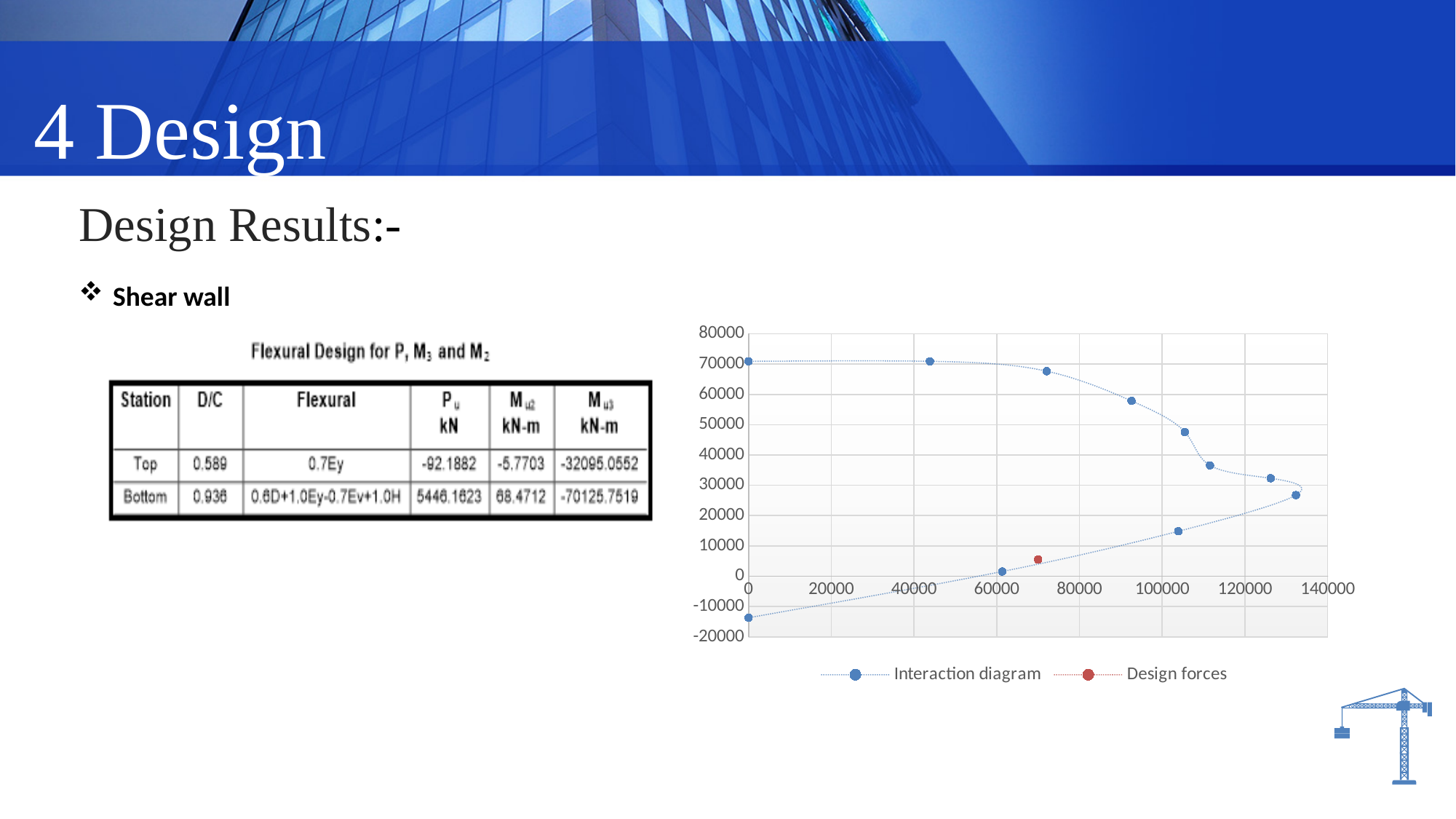
How many points are plotted for the Design forces series? 1 Is the lowest vertical-axis value of the Interaction diagram greater or less than -10000? less What are the two series named in the chart legend? Interaction diagram, Design forces Is the highest vertical-axis value of the Interaction diagram greater or less than 60000? greater Is the horizontal-axis value of the Design forces point greater or less than 60000? greater How many series does the chart legend list? 2 How many points are plotted for the Interaction diagram series? 11 What colour is the Design forces marker in the chart? red What kind of chart is shown on the slide? scatter chart What is the maximum value shown on the vertical axis of the chart? 80000